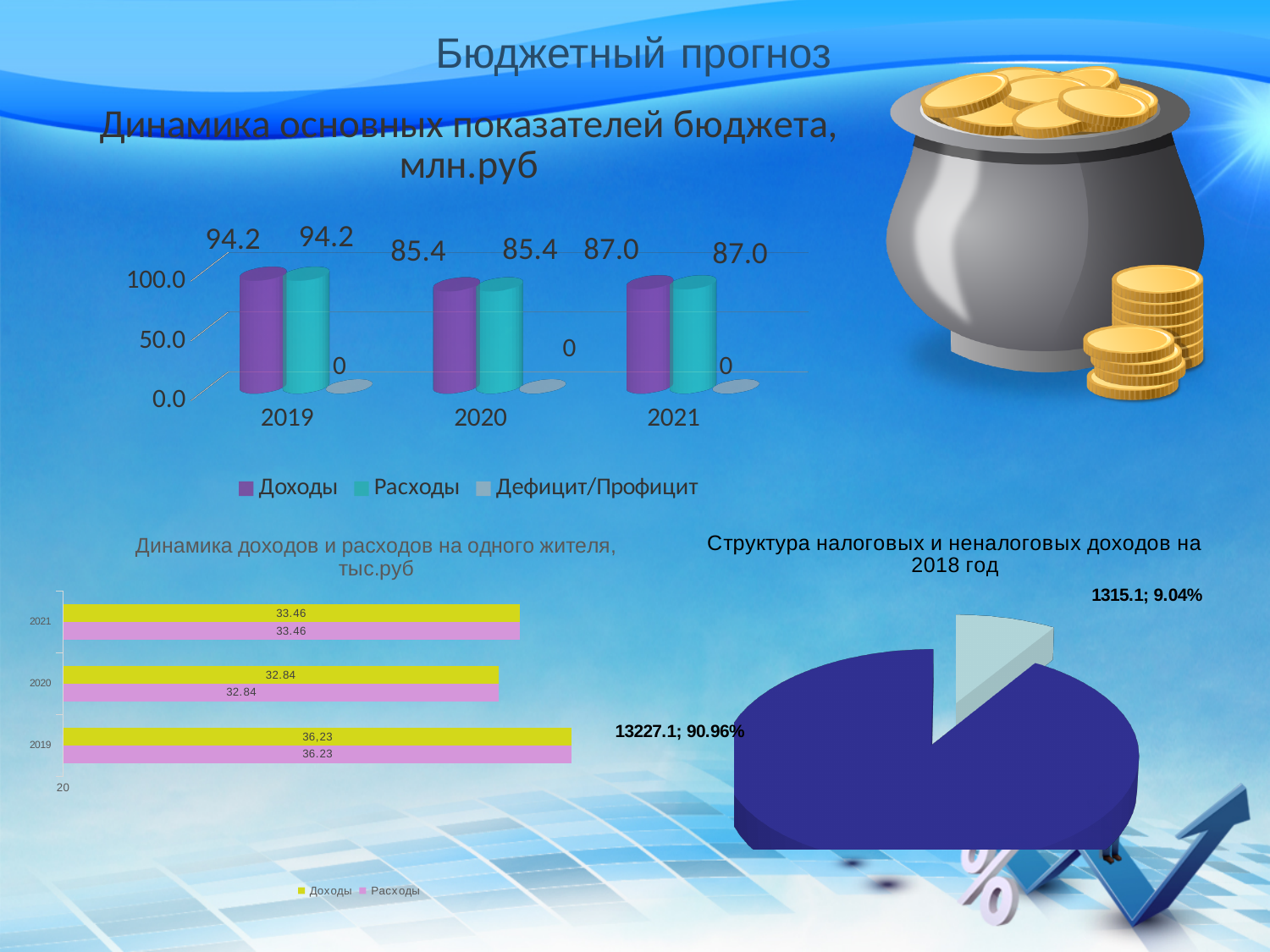
In the chart 'Динамика основных показателей бюджета, млн.руб', what is the value of Дефицит/Профицит for 2021? 0 In the chart 'Динамика доходов и расходов на одного жителя, тыс.руб', what is the value of Расходы for 2021? 33.46 What type of chart is 'Динамика основных показателей бюджета, млн.руб'? Bar chart In the pie chart 'Структура налоговых и неналоговых доходов на 2018 год', what is the value of the smaller slice? 1315.1 In the chart 'Динамика основных показателей бюджета, млн.руб', what is the value of Доходы for 2019? 94.2 In the chart 'Динамика основных показателей бюджета, млн.руб', which year has the highest Доходы? 2019 How many series does the legend of the chart 'Динамика основных показателей бюджета, млн.руб' list? 3 In the chart 'Динамика доходов и расходов на одного жителя, тыс.руб', which year has the lowest Доходы? 2020 In the chart 'Динамика доходов и расходов на одного жителя, тыс.руб', how many years are shown? 3 In the chart 'Динамика основных показателей бюджета, млн.руб', what is the value of Расходы for 2020? 85.4 In the chart 'Динамика основных показателей бюджета, млн.руб', what is the difference between Доходы in 2019 and Доходы in 2020? 8.8 In the pie chart 'Структура налоговых и неналоговых доходов на 2018 год', what share does the largest slice have? 90.96%